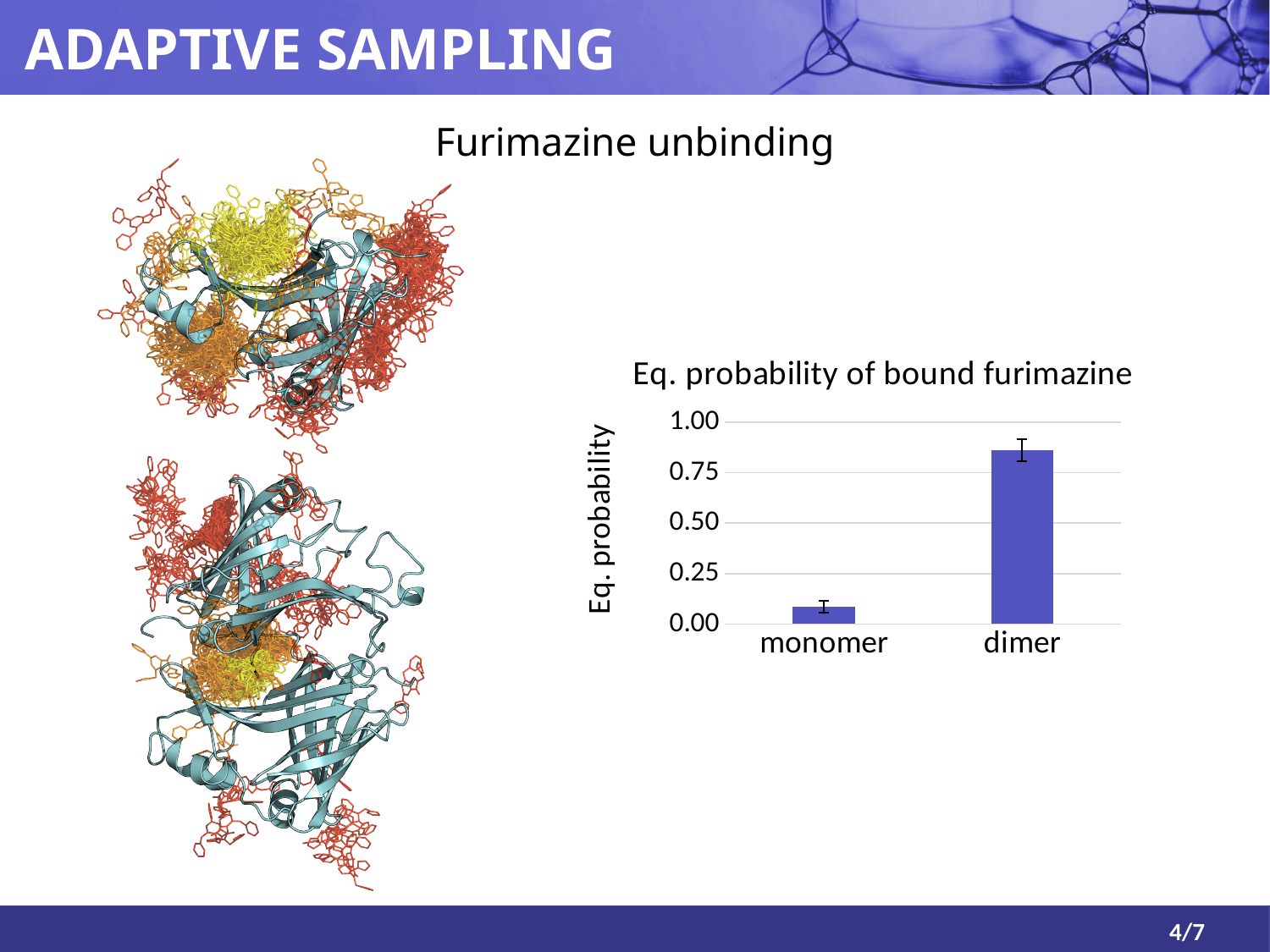
Is the value for monomer greater or less than 0.25? less What is the label of the y axis of the chart? Eq. probability Which has a larger Eq. probability, monomer or dimer? dimer Is the value for dimer greater or less than 0.75? greater What is the title of the chart? Eq. probability of bound furimazine Is the value for dimer greater or less than 1.00? less How many categories are shown on the x axis of the chart? 2 Do the values rise or fall from monomer to dimer along the x axis? rise Which category has the lowest Eq. probability? monomer Which category has the highest Eq. probability? dimer What kind of chart is shown on the slide? bar chart